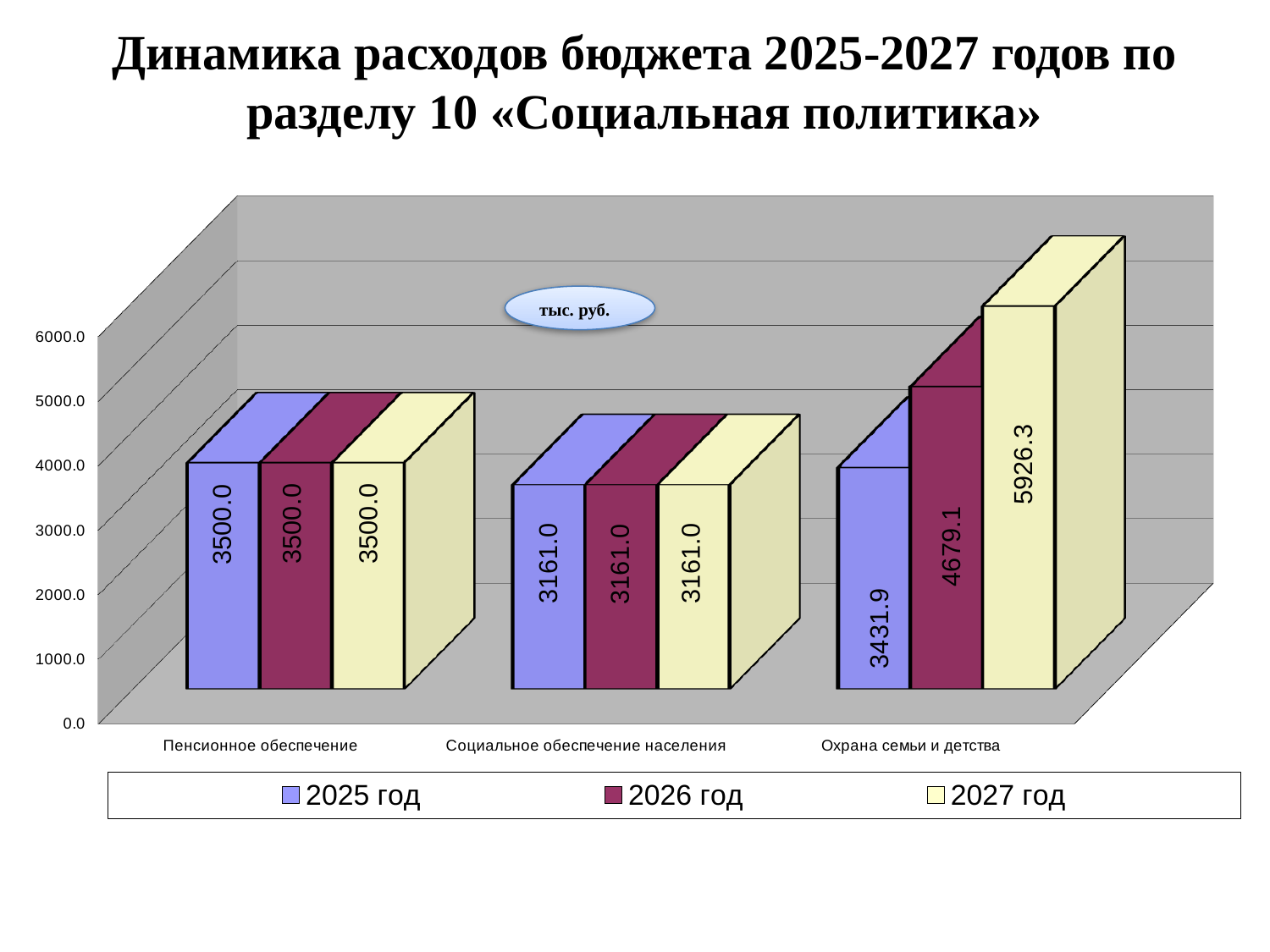
What is the difference between the 2027 год and 2025 год values for Охрана семьи и детства? 2494.4 Do the values for Охрана семьи и детства rise or fall from 2025 год to 2027 год? Rise What is the value for Социальное обеспечение населения in 2026 год? 3161.0 What is the value for Пенсионное обеспечение in 2025 год? 3500.0 Which category has the highest value in 2027 год? Охрана семьи и детства Which category has the lowest value in 2025 год? Социальное обеспечение населения What is the value for Охрана семьи и детства in 2025 год? 3431.9 What kind of chart is shown on the slide? Bar chart How many series does the legend list? 3 Which is larger: the 2026 год value for Охрана семьи и детства or the 2026 год value for Пенсионное обеспечение? Охрана семьи и детства What is the value for Охрана семьи и детства in 2027 год? 5926.3 How many categories are shown on the x axis? 3